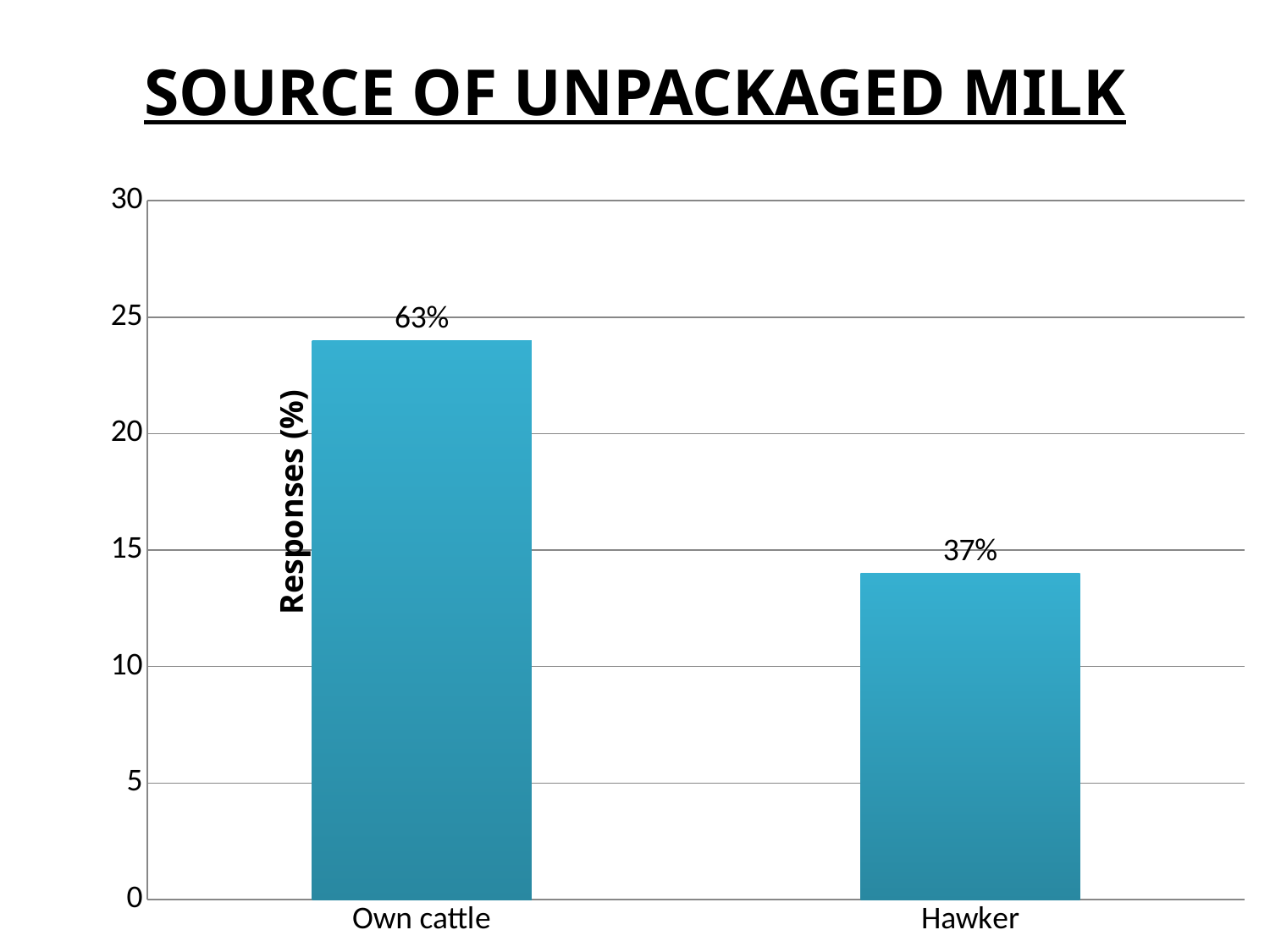
Is the bar for Hawker greater or less than 10 on the y axis? greater Is the bar for Hawker greater or less than 20 on the y axis? less What data label is shown on the bar for Own cattle? 63% What is the difference between the labelled percentages for Own cattle and Hawker? 26% Is the bar for Own cattle greater or less than 20 on the y axis? greater How many categories are shown on the x axis? 2 Which source of unpackaged milk has the lowest bar? Hawker What is the title of the slide? SOURCE OF UNPACKAGED MILK Which is larger, the value for Own cattle or the value for Hawker? Own cattle What data label is shown on the bar for Hawker? 37% What kind of chart is shown on the slide? Bar chart Which source of unpackaged milk has the highest bar? Own cattle